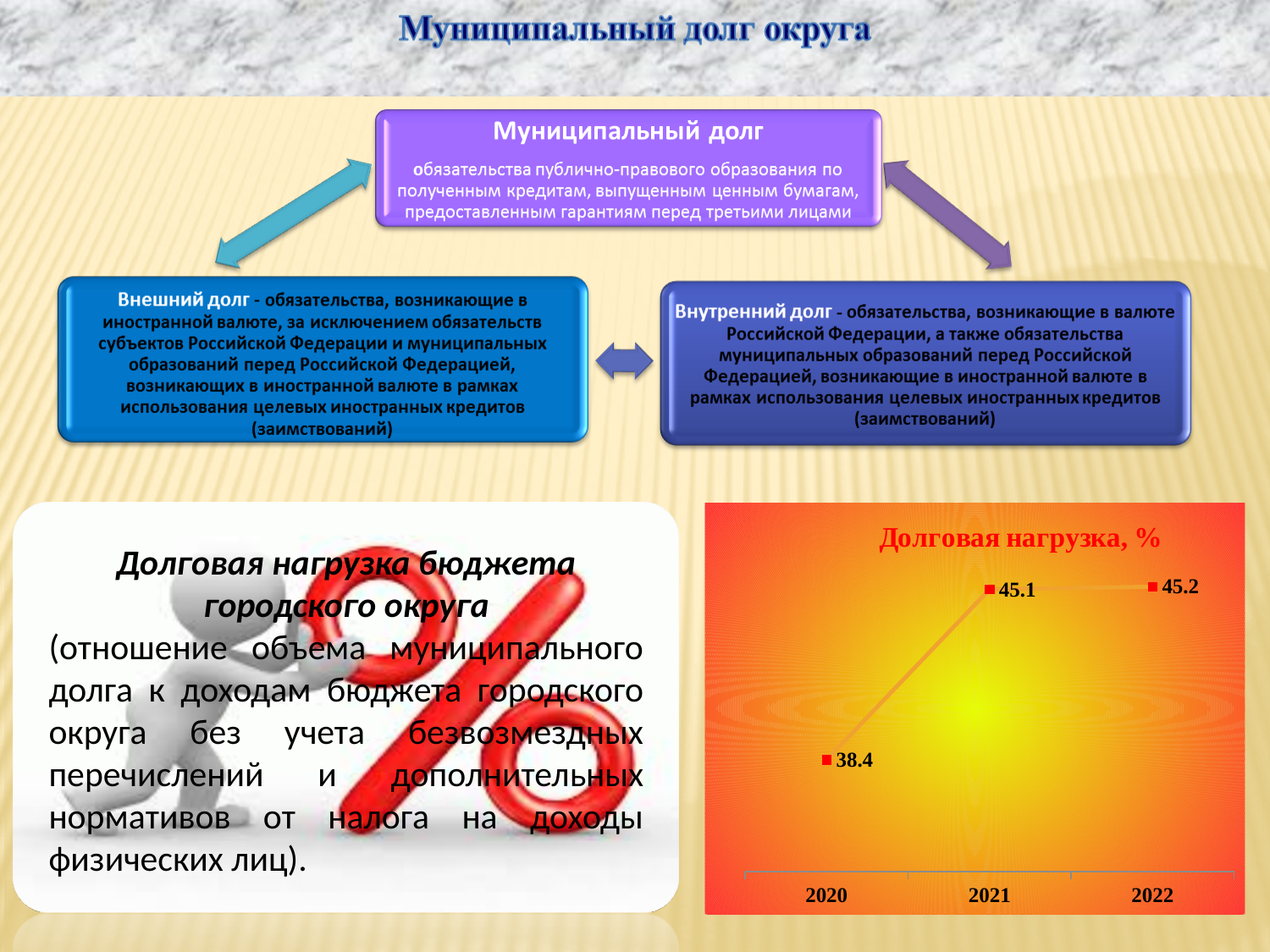
What is the title of the chart on the right side of the slide? Долговая нагрузка, % Which year has the lowest value in the chart "Долговая нагрузка, %"? 2020 Do the values in the chart "Долговая нагрузка, %" rise or fall from 2020 to 2022? rise Which year has the highest value in the chart "Долговая нагрузка, %"? 2022 What is the difference between the values for 2022 and 2021 in the chart "Долговая нагрузка, %"? 0.1 What is the value for 2021 in the chart "Долговая нагрузка, %"? 45.1 What is the difference between the values for 2021 and 2020 in the chart "Долговая нагрузка, %"? 6.7 What is the value for 2022 in the chart "Долговая нагрузка, %"? 45.2 How many years are plotted in the chart "Долговая нагрузка, %"? 3 In the chart "Долговая нагрузка, %", which is larger: the value for 2020 or the value for 2021? 2021 What is the value for 2020 in the chart "Долговая нагрузка, %"? 38.4 What kind of chart is "Долговая нагрузка, %"? line chart